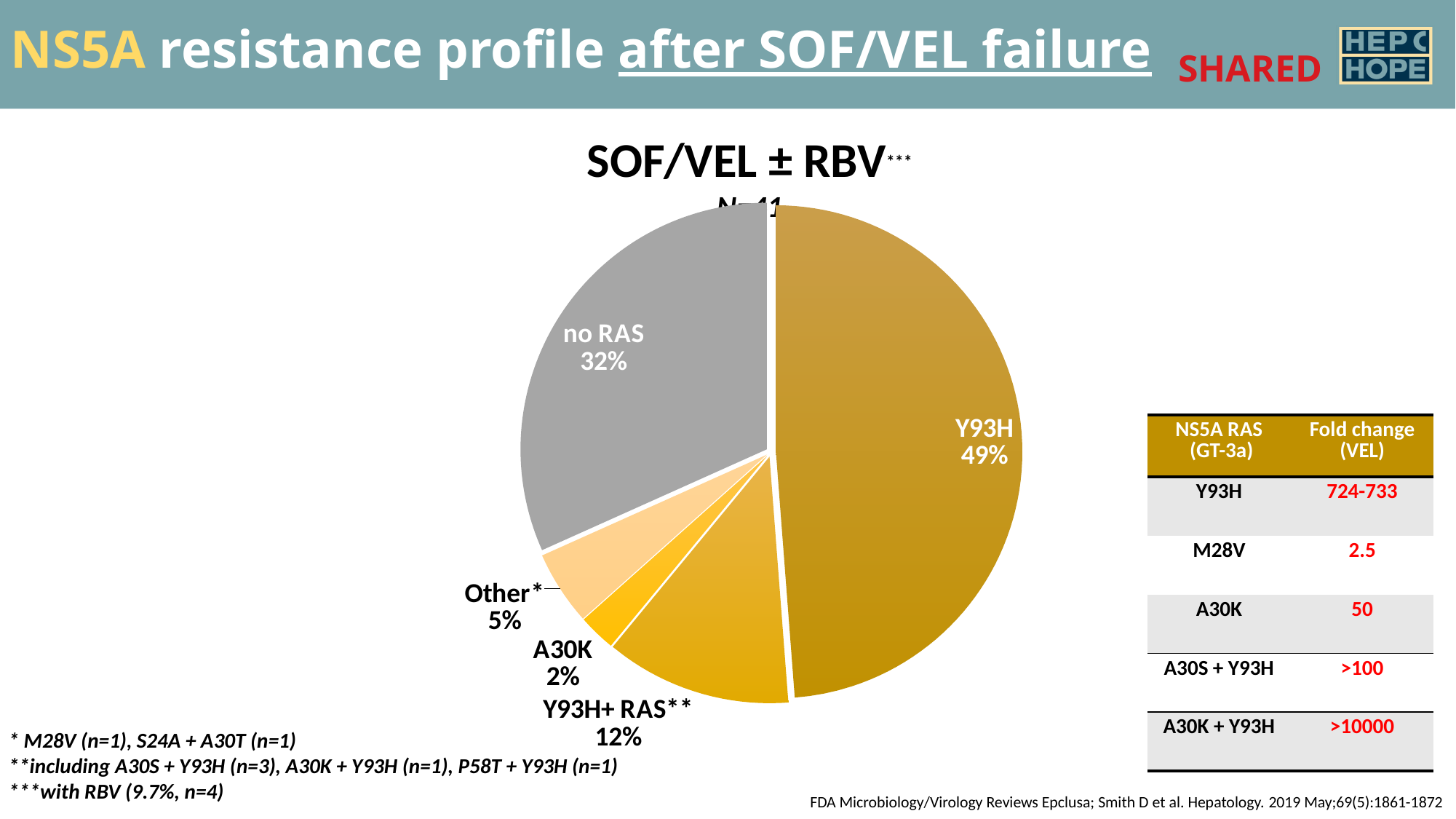
Which is larger, the 'Other' slice or the 'Y93H+ RAS' slice? Y93H+ RAS Which slice of the pie is the smallest? A30K Which slice of the pie is the largest? Y93H How many slices does the pie chart have? 5 What percentage is shown for the 'no RAS' slice? 32% What share of the pie does the Y93H slice represent? 49% What percentage is shown for the 'Y93H+ RAS' slice? 12% What is the title of the pie chart? SOF/VEL ± RBV What is the difference in percentage points between the Y93H slice and the 'no RAS' slice? 17 What percentage is shown for the 'Other' slice? 5% What percentage is shown for the A30K slice? 2% What kind of chart is shown on the slide? pie chart